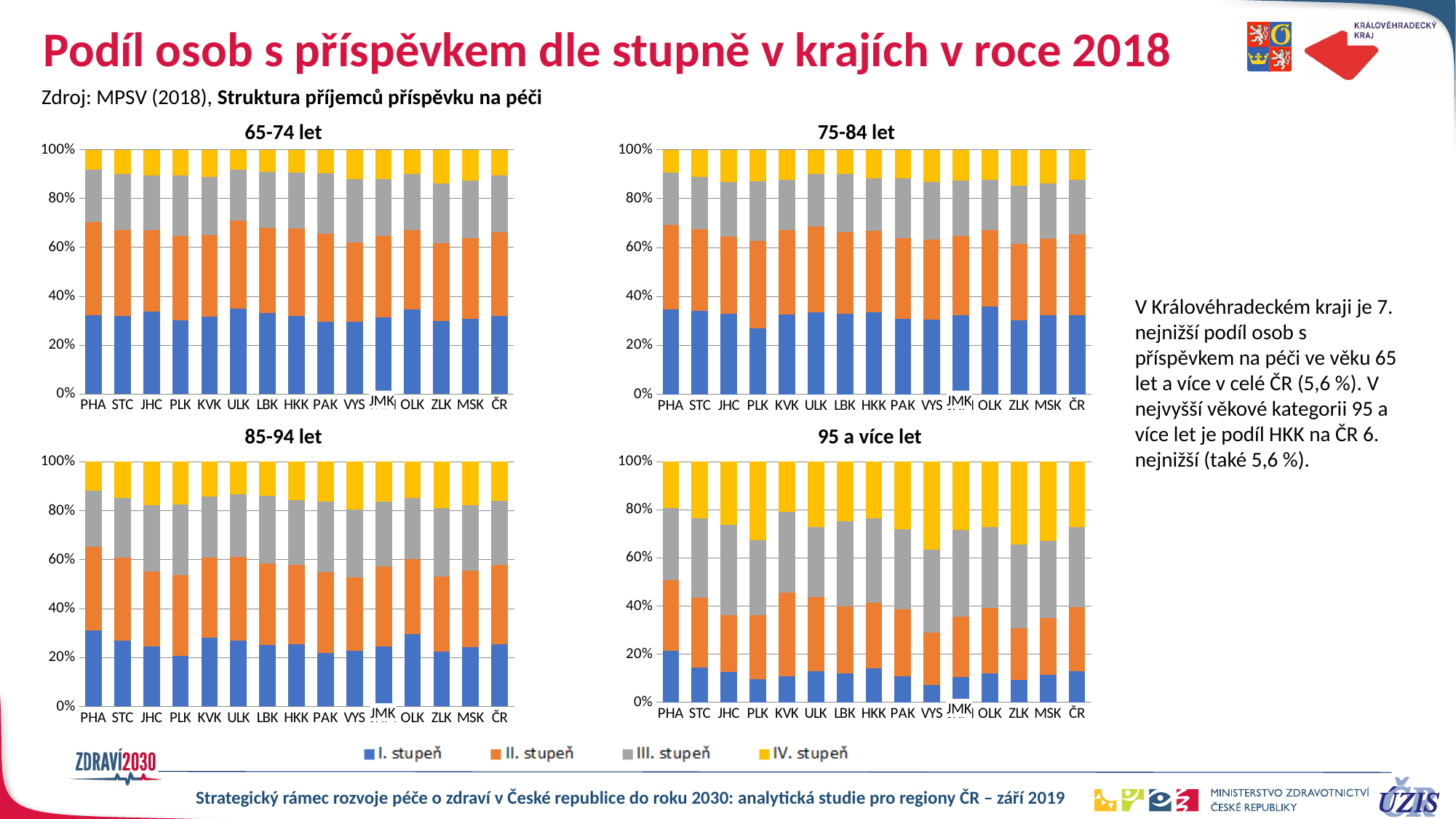
What is the title of the bottom-right chart? 95 a více let What kind of chart is the "65-74 let" chart? stacked bar chart In the "95 a více let" chart, which has the larger IV. stupeň share, VYS or PHA? VYS In the "65-74 let" chart, is the I. stupeň share for ULK greater or less than 40%? less In the "95 a více let" chart, which region has the highest I. stupeň share? PHA In the "95 a více let" chart, is the I. stupeň share for VYS greater or less than 20%? less Which series is shown in yellow in the legend? IV. stupeň How many series does the shared legend list? 4 In the "75-84 let" chart, is the I. stupeň share for PLK greater or less than 40%? less In the "75-84 let" chart, which region has the lowest I. stupeň share? PLK How many regions (categories) are shown on the x axis of the "95 a více let" chart? 15